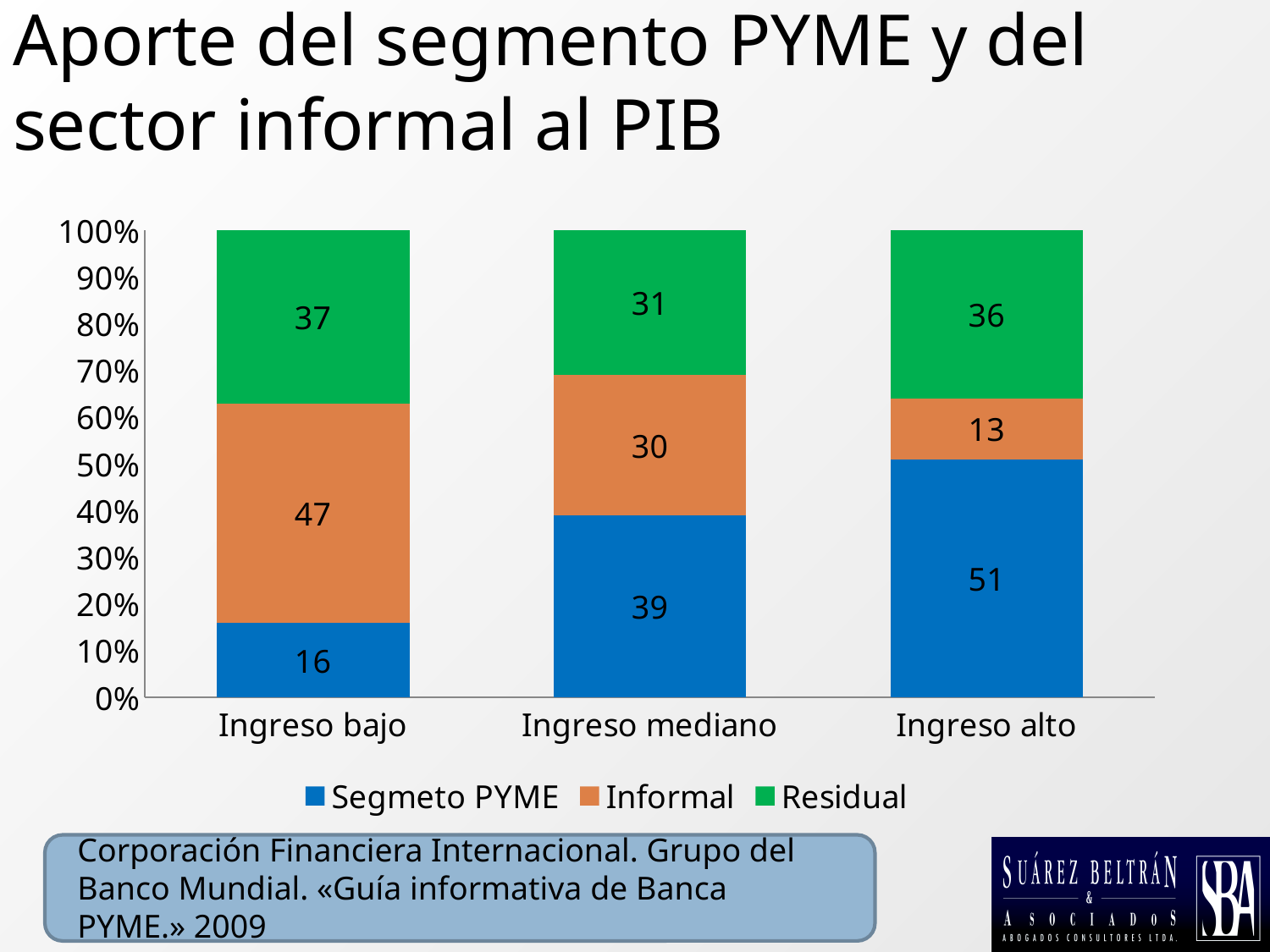
Which is larger: the Residual value for Ingreso bajo or for Ingreso mediano? Ingreso bajo What is the value of Segmeto PYME for Ingreso bajo? 16 What kind of chart is shown on the slide? Stacked bar chart Do the Segmeto PYME values rise or fall from Ingreso bajo to Ingreso alto? Rise What is the difference between the Informal values for Ingreso bajo and Ingreso alto? 34 How many series does the legend list? 3 Which category has the highest Segmeto PYME value? Ingreso alto What is the value of Informal for Ingreso mediano? 30 Which category has the lowest Informal value? Ingreso alto What is the value of Residual for Ingreso alto? 36 How many categories are shown on the x axis? 3 What is the total of the stacked bar for Ingreso mediano? 100